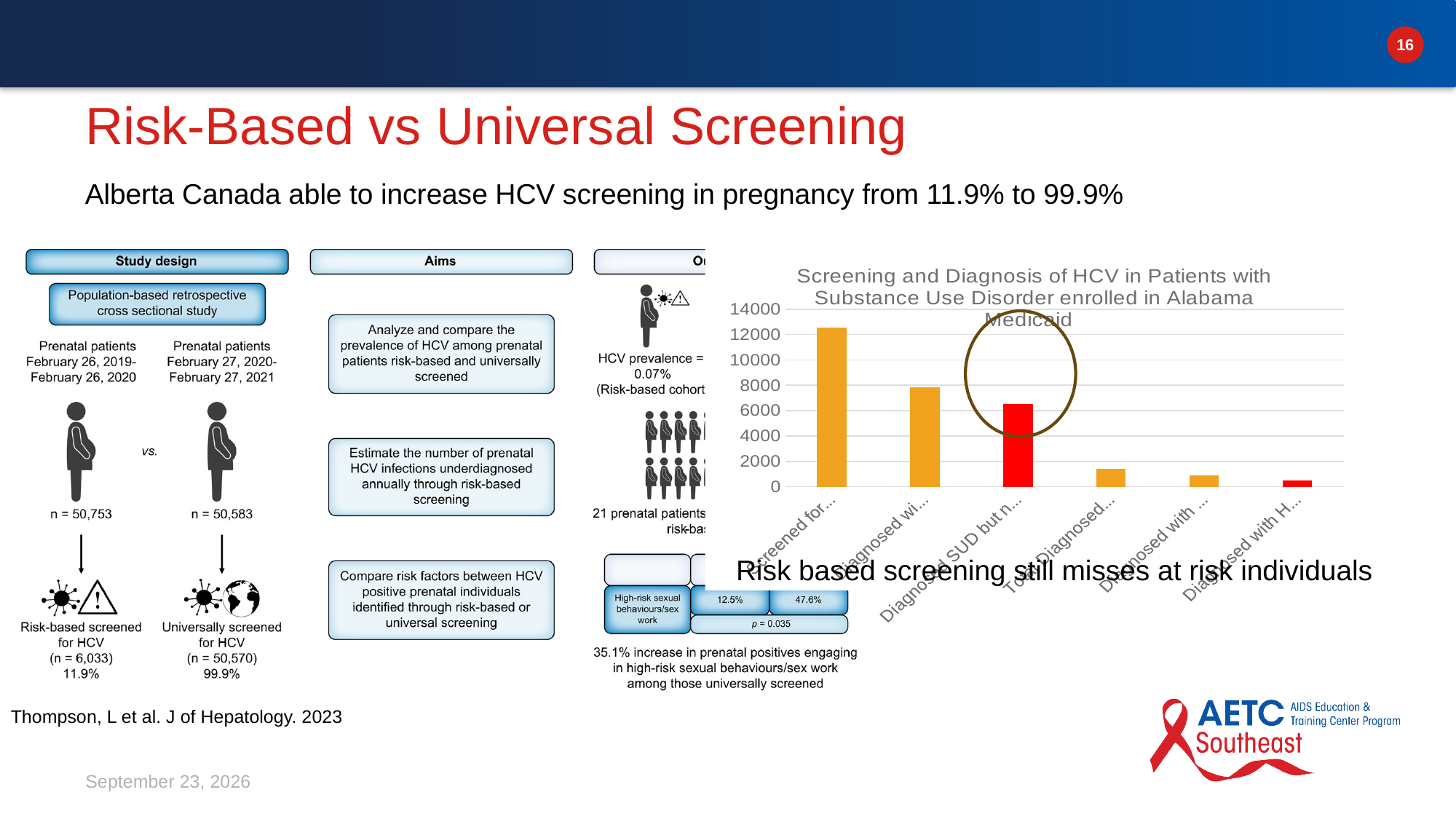
Do the bar values generally rise or fall from left to right across the chart? fall Is the value of the fourth bar (Total Diagnosed...) greater or less than 2000? less What kind of chart is shown on the slide? bar chart Is the value of the first bar (Screened for...) greater or less than 10000? greater How many bars in the chart are coloured red rather than orange? 2 What is the title of the chart? Screening and Diagnosis of HCV in Patients with Substance Use Disorder enrolled in Alabama Medicaid Is the value of the third bar (Diagnosed SUD but n...) greater or less than 4000? greater Which bar in the chart is the shortest? the last bar (Diagnosed with H...) Which bar in the chart is the tallest? the first bar (Screened for...) How many bars are plotted in the chart? 6 Which is larger, the first bar or the second bar in the chart? the first bar